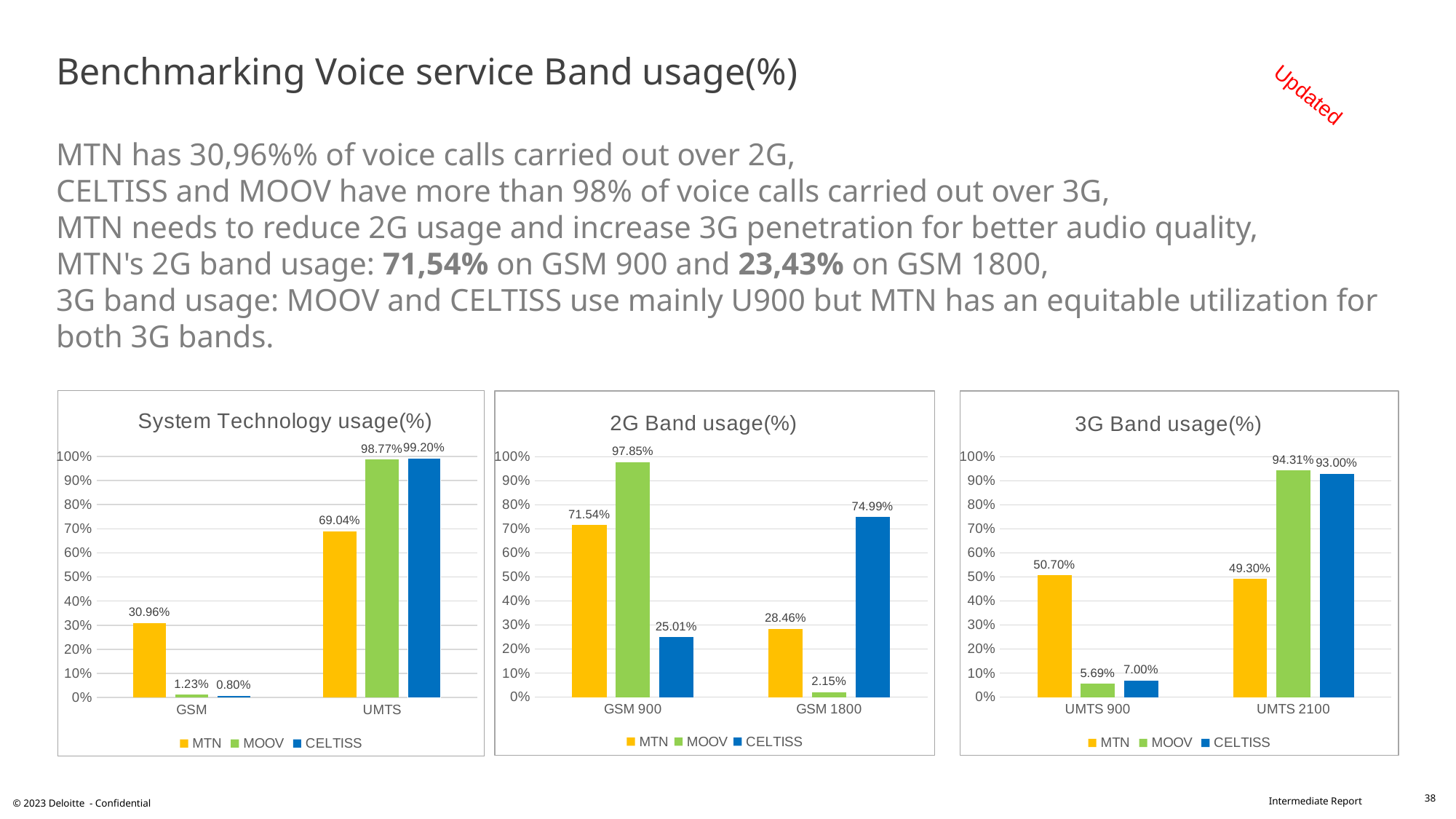
In the 2G Band usage(%) chart, what is the value for CELTISS on GSM 1800? 74.99% How many series does the legend of the 2G Band usage(%) chart list? 3 In the System Technology usage(%) chart, what is the value for CELTISS on UMTS? 99.20% In the 3G Band usage(%) chart, which series has the highest value on UMTS 2100? MOOV In the System Technology usage(%) chart, what is the value for MTN on GSM? 30.96% What kind of chart is the 3G Band usage(%) chart? Bar chart In the 3G Band usage(%) chart, what is the value for MTN on UMTS 900? 50.70% In the System Technology usage(%) chart, which colour represents MOOV? Green In the 2G Band usage(%) chart, what is the value for MOOV on GSM 900? 97.85% In the 3G Band usage(%) chart, which is larger on UMTS 900: MOOV or CELTISS? CELTISS In the 2G Band usage(%) chart, which series has the lowest value on GSM 1800? MOOV In the 2G Band usage(%) chart, what is the difference between MTN's values on GSM 900 and GSM 1800? 43.08%